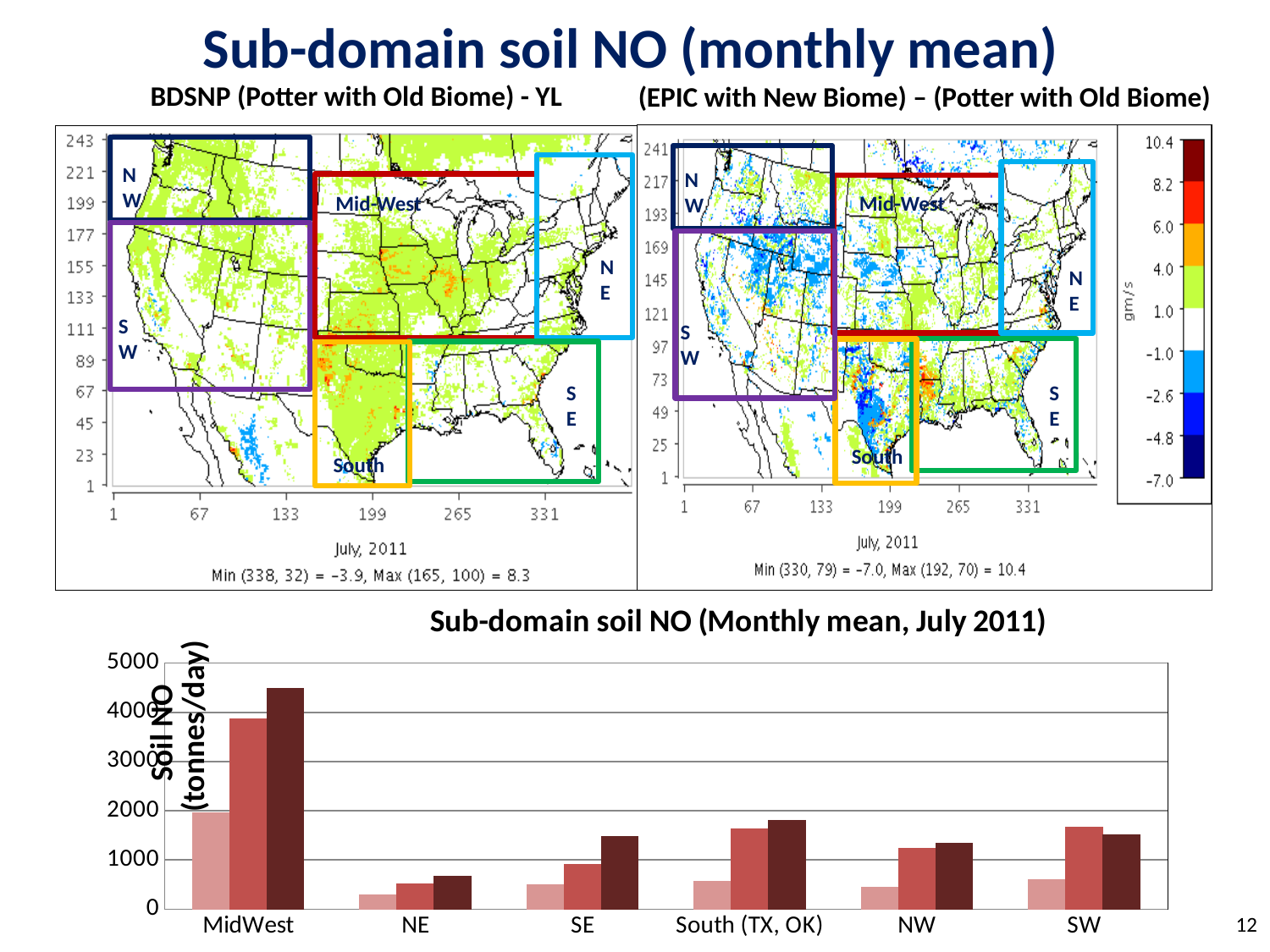
Is the tallest bar for SE greater or less than 1000 tonnes/day? greater What kind of chart is shown at the bottom of the slide? bar chart Which sub-domain has the highest soil NO values in the bar chart? MidWest Which sub-domain has taller bars, MidWest or SW? MidWest Is the tallest bar for NE greater or less than 1000 tonnes/day? less Is the tallest bar for MidWest greater or less than 4000 tonnes/day? greater Which sub-domain has the lowest soil NO values in the bar chart? NE What is the title of the bar chart? Sub-domain soil NO (Monthly mean, July 2011) How many sub-domain categories are shown on the x axis of the bar chart? 6 Which sub-domain has taller bars, NW or NE? NW How many bars are plotted for each sub-domain in the bar chart? 3